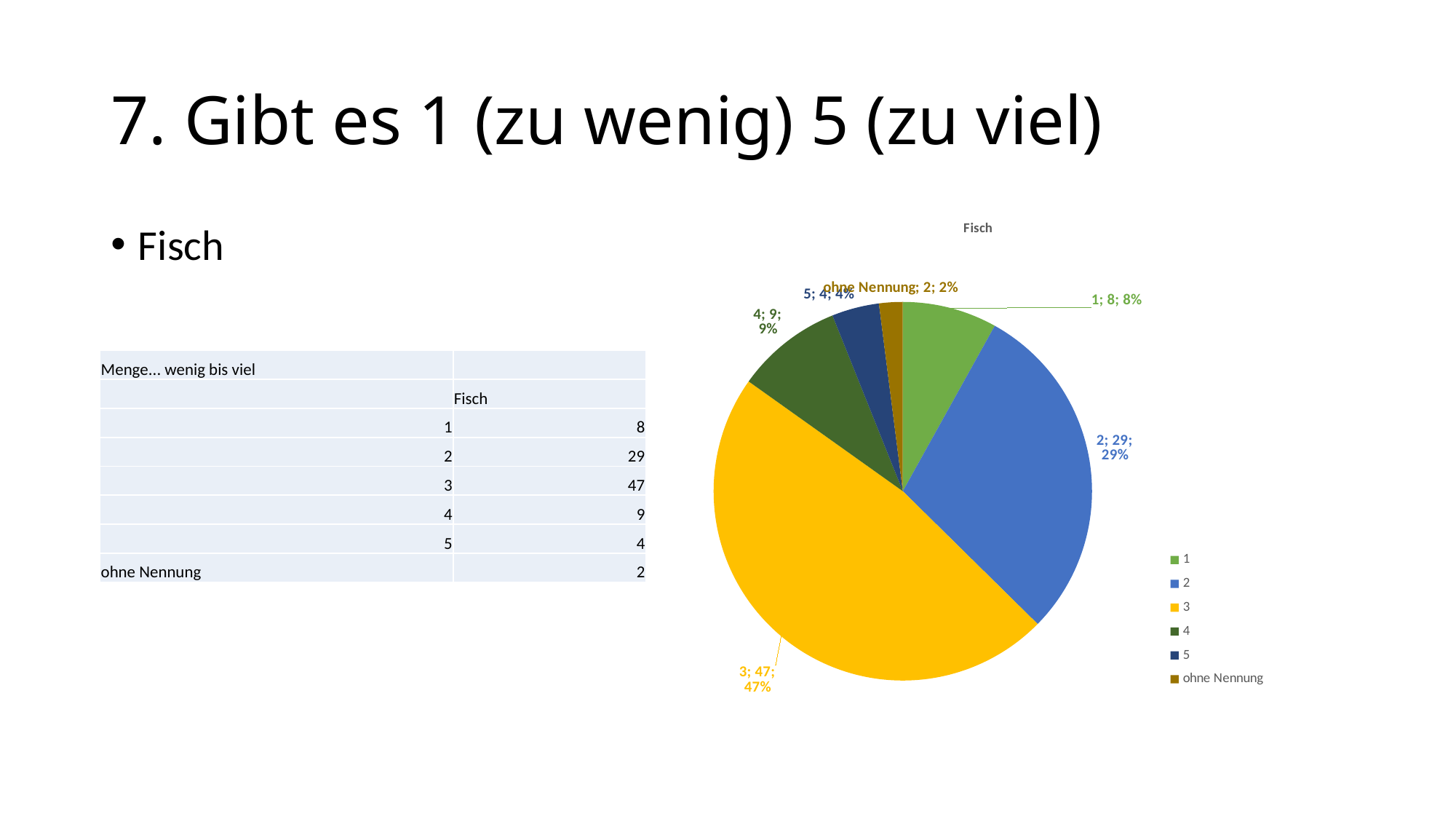
Which category has the smallest slice in the pie chart? ohne Nennung What kind of chart is shown on the slide? pie chart What is the title of the chart? Fisch How many entries does the legend list? 6 Which category has the largest slice in the pie chart? 3 What is the value for 'ohne Nennung' in the pie chart? 2 Which is larger, the value for category 4 or the value for category 5? 4 What share of the pie does category 2 represent? 29% How many slices does the pie chart have? 6 What is the value for category 2 in the pie chart? 29 What is the difference between the values for category 3 and category 2? 18 What is the value for category 3 in the pie chart? 47